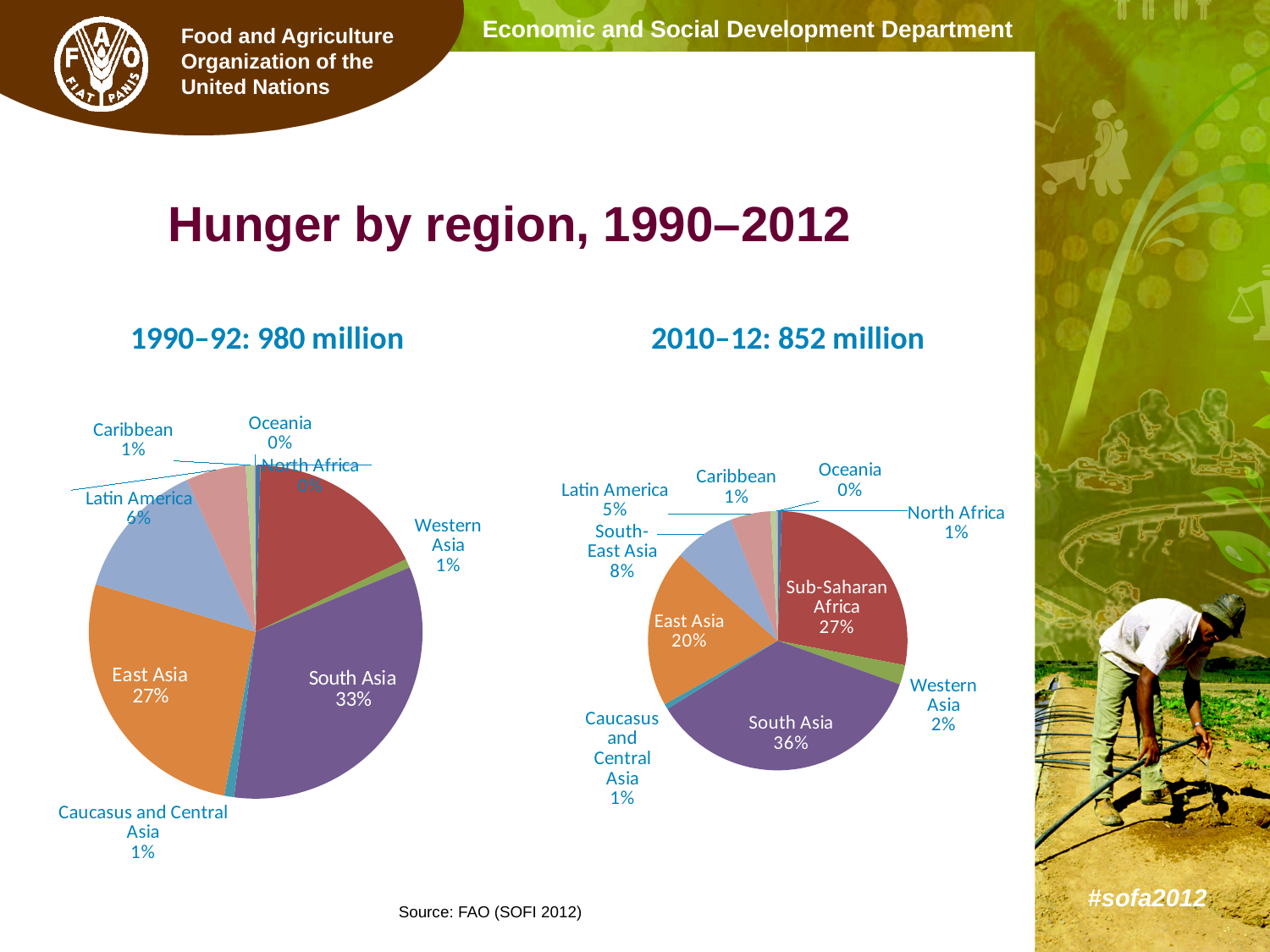
In the 2010–12 pie chart, which region has the largest slice? South Asia In the 2010–12 pie chart, by how many percentage points does South Asia's share exceed East Asia's share? 16 percentage points In the 1990–92 pie chart, which slice is larger, South Asia or East Asia? South Asia In the 1990–92 pie chart, what share is labelled for Latin America? 6% In the 1990–92 pie chart, what share is labelled for East Asia? 27% In the 2010–12 pie chart, what share is labelled for Sub-Saharan Africa? 27% What kind of charts are shown on the slide? Pie charts According to the chart headings, how many million hungry people were there in 2010–12? 852 million